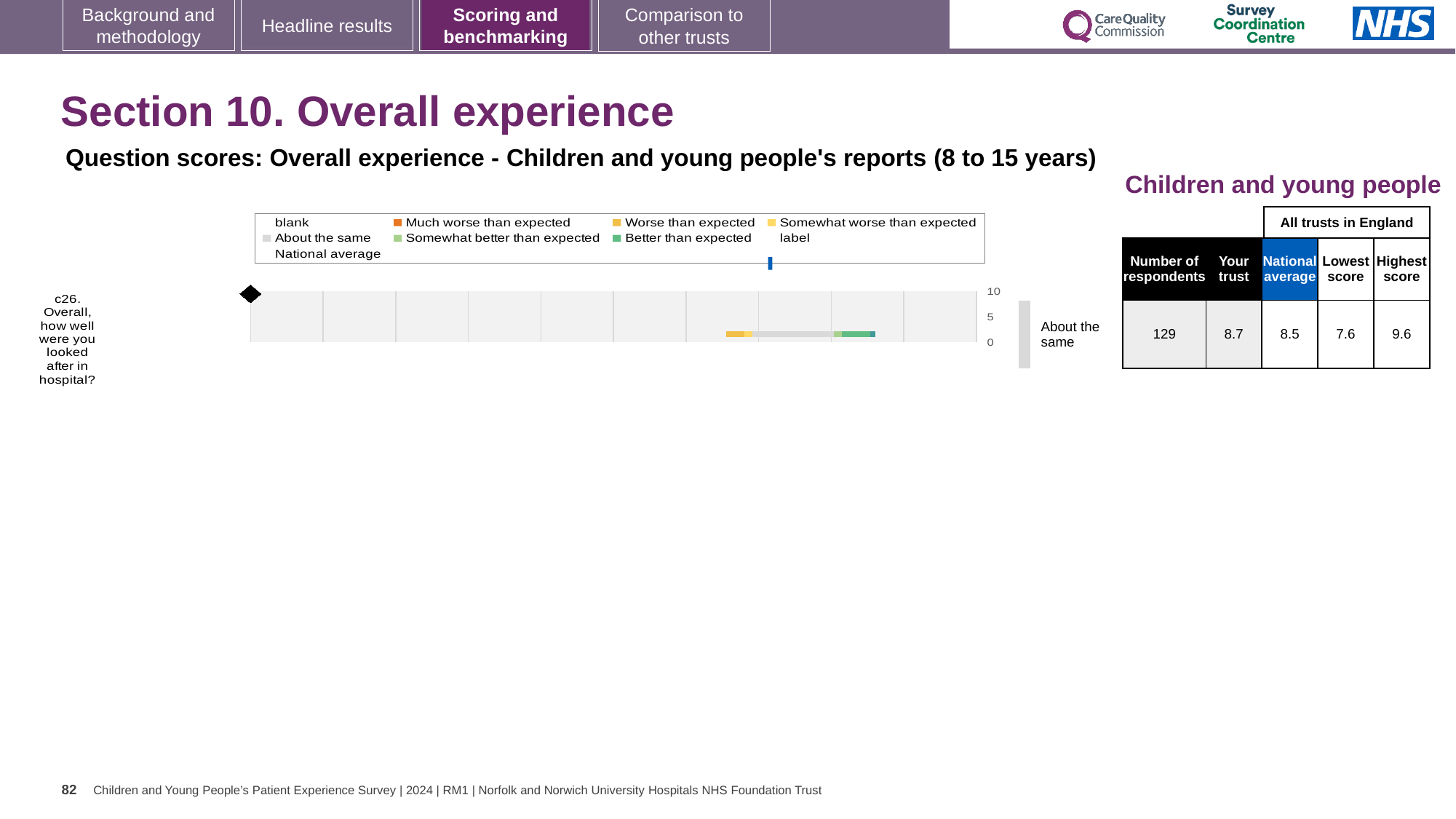
By how much does the 'Your trust' score (8.7) exceed the national average (8.5) for question c26? 0.2 What kind of chart is used to show the c26 question score? bar chart How many survey questions are plotted in the chart? 1 What is the highest score among all trusts in England for question c26? 9.6 What is the lowest score among all trusts in England for question c26? 7.6 What is the 'Your trust' score for question c26 'Overall, how well were you looked after in hospital?' 8.7 What colour does the legend use for 'Much worse than expected'? orange Which is higher for question c26: the 'Your trust' score or the national average? Your trust How many respondents answered question c26? 129 What is the difference between the highest score (9.6) and the lowest score (7.6) for question c26? 2.0 What benchmark category label is shown next to the chart for question c26? About the same What is the national average score for question c26? 8.5